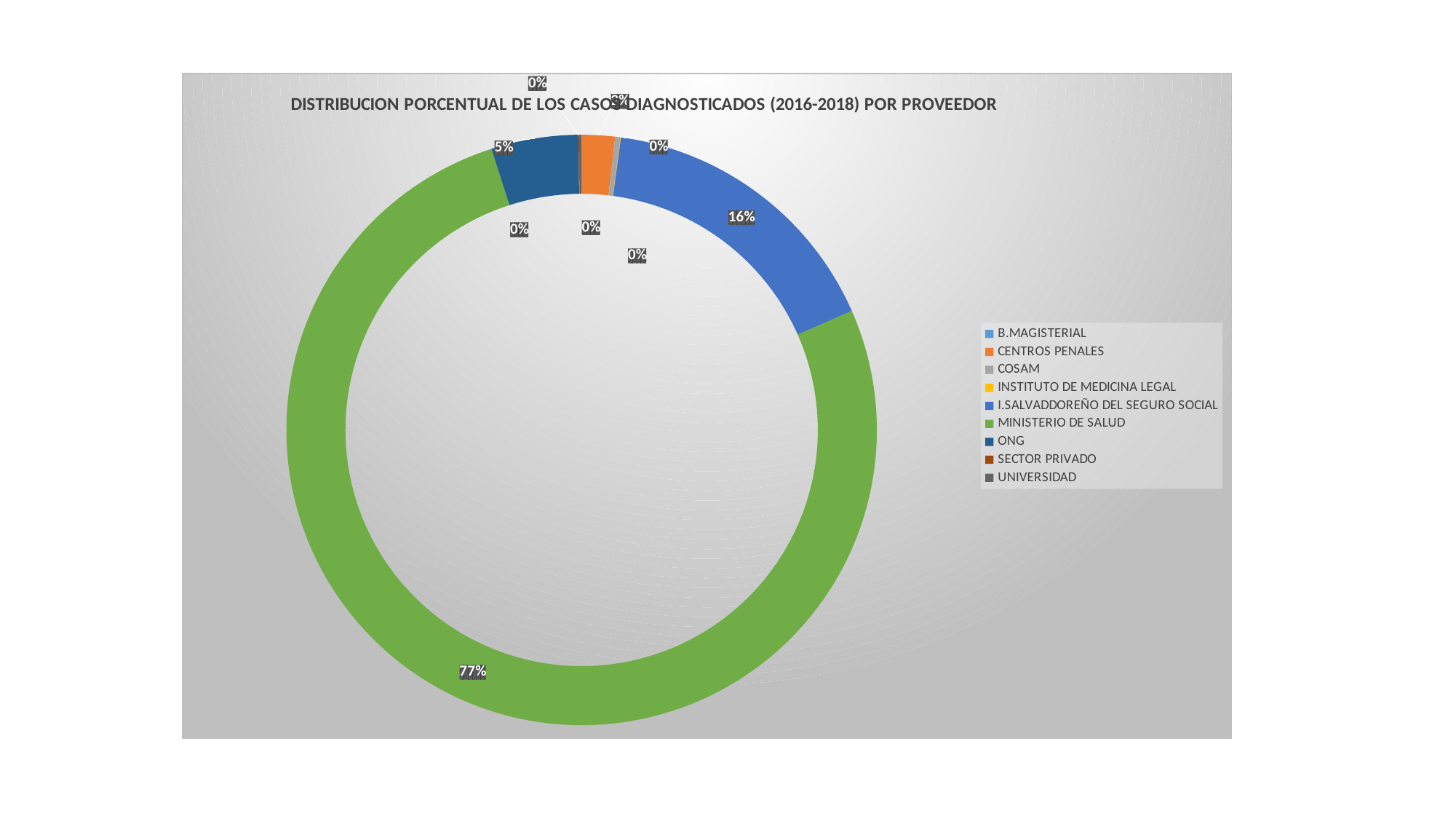
What share of the diagnosed cases does MINISTERIO DE SALUD account for? 77% How many providers are listed in the legend? 9 Which provider has the largest share of diagnosed cases? MINISTERIO DE SALUD Which is larger, the share for ONG or the share for I.SALVADDOREÑO DEL SEGURO SOCIAL? I.SALVADDOREÑO DEL SEGURO SOCIAL Is the share for MINISTERIO DE SALUD greater or less than 50%? greater By how many percentage points does I.SALVADDOREÑO DEL SEGURO SOCIAL exceed ONG? 11 percentage points What percentage is shown for I.SALVADDOREÑO DEL SEGURO SOCIAL? 16% Which colour represents MINISTERIO DE SALUD in the chart? Green What type of chart is shown on the slide? Doughnut (pie) chart What is the title of the chart? DISTRIBUCION PORCENTUAL DE LOS CASOS DIAGNOSTICADOS (2016-2018) POR PROVEEDOR By how many percentage points does MINISTERIO DE SALUD exceed I.SALVADDOREÑO DEL SEGURO SOCIAL? 61 percentage points What percentage of cases is attributed to ONG? 5%